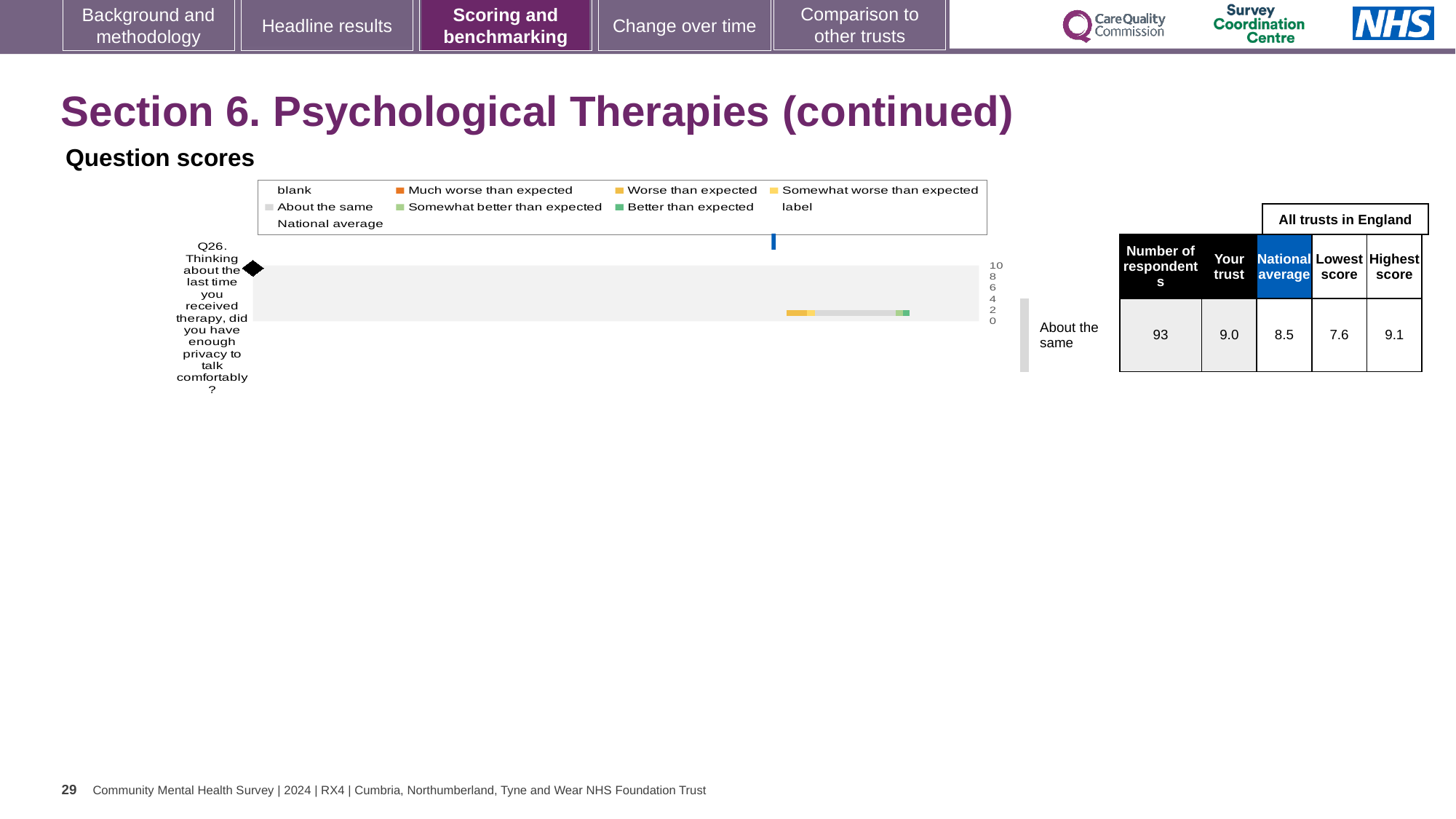
Which is larger for Q26: the 'Your trust' score or the national average? Your trust How many survey questions are plotted in the Question scores chart? 1 How many respondents answered Q26, according to the table beside the chart? 93 According to the table beside the chart, what is the lowest score among all trusts in England for Q26? 7.6 According to the table beside the chart, what is the national average score for Q26? 8.5 What benchmark category is shown next to the Q26 bar in the chart? About the same Which question number is plotted in the Question scores chart? Q26 What colour does the chart legend use for 'Better than expected'? green What is the difference between the highest score and the lowest score for Q26 in the table beside the chart? 1.5 According to the table beside the chart, what is the 'Your trust' score for Q26? 9.0 What kind of chart is shown under 'Question scores'? bar chart According to the table beside the chart, what is the highest score among all trusts in England for Q26? 9.1